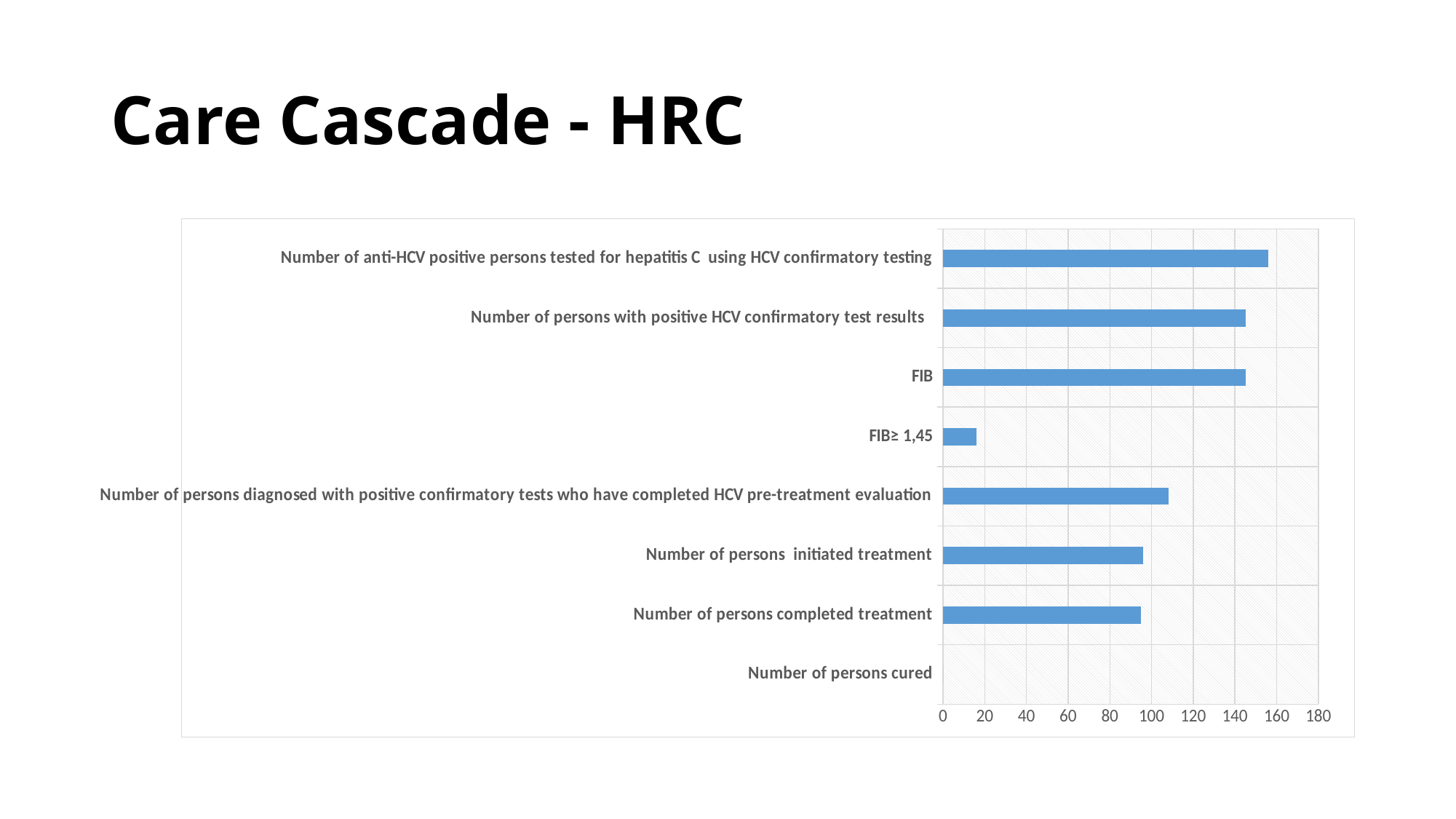
Is the value for Number of persons completed treatment greater or less than 80? greater Is the value for Number of persons diagnosed with positive confirmatory tests who have completed HCV pre-treatment evaluation greater or less than 100? greater How many categories are plotted in the chart? 8 What kind of chart is shown on the slide? Bar chart Which is larger, the value for FIB or the value for FIB≥ 1,45? FIB Is the value for Number of anti-HCV positive persons tested for hepatitis C using HCV confirmatory testing greater or less than 140? greater What is the title of the slide containing the chart? Care Cascade - HRC Which category has the lowest value in the chart? Number of persons cured Which is larger, the value for Number of persons diagnosed with positive confirmatory tests who have completed HCV pre-treatment evaluation or the value for Number of persons initiated treatment? Number of persons diagnosed with positive confirmatory tests who have completed HCV pre-treatment evaluation Which category has the highest value in the chart? Number of anti-HCV positive persons tested for hepatitis C using HCV confirmatory testing